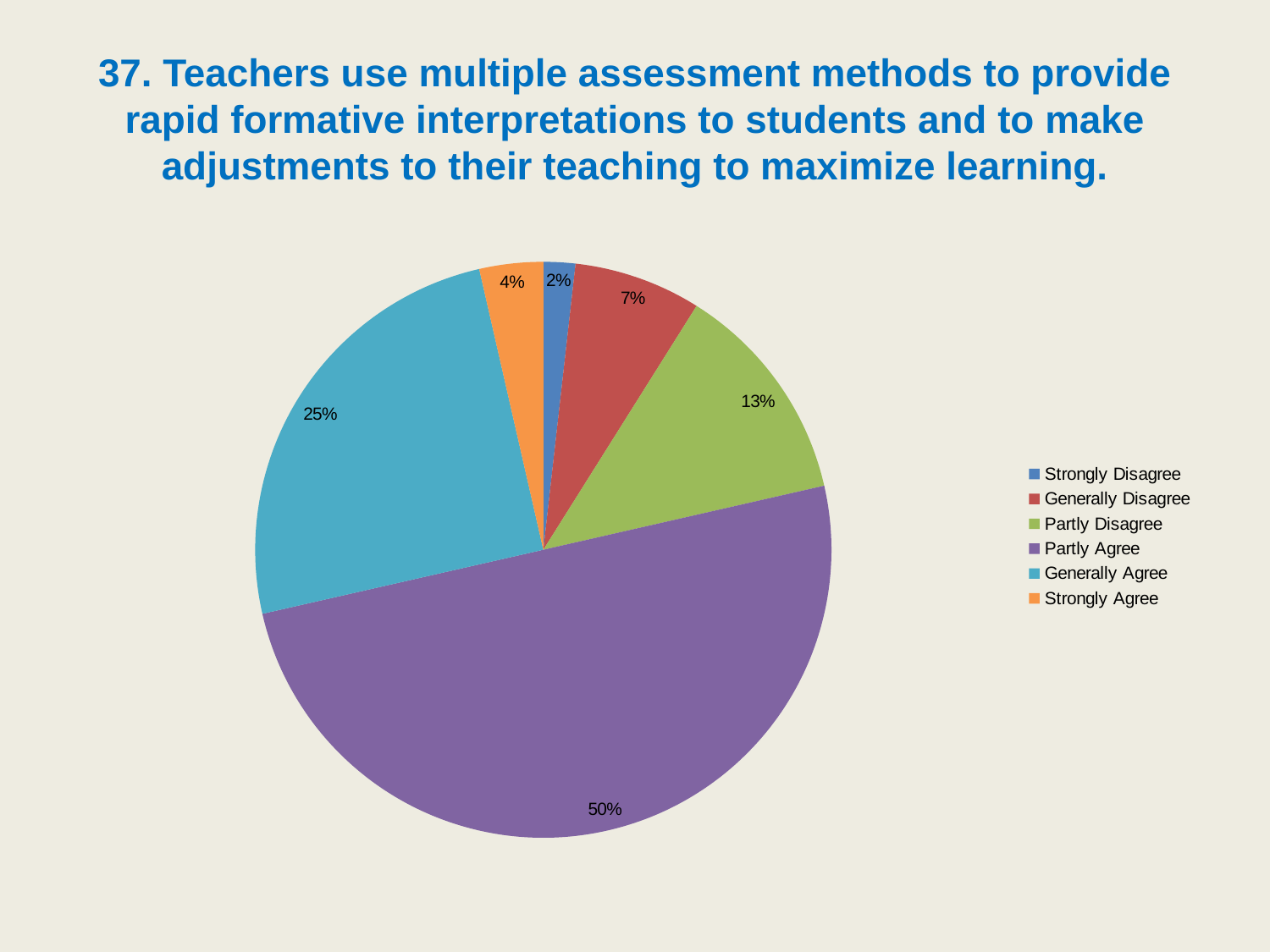
How many categories does the legend list? 6 What type of chart is shown on the slide? pie chart What is the difference in percentage points between Partly Agree and Generally Agree? 25 Which response category has the smallest share of the pie? Strongly Disagree What percentage of respondents chose Partly Disagree? 13% What percentage of respondents chose Partly Agree? 50% Which is larger, the share for Partly Disagree or the share for Generally Disagree? Partly Disagree What percentage of respondents chose Strongly Disagree? 2% What percentage of respondents chose Generally Disagree? 7% Which response category has the largest share of the pie? Partly Agree What percentage of respondents chose Strongly Agree? 4% What percentage of respondents chose Generally Agree? 25%